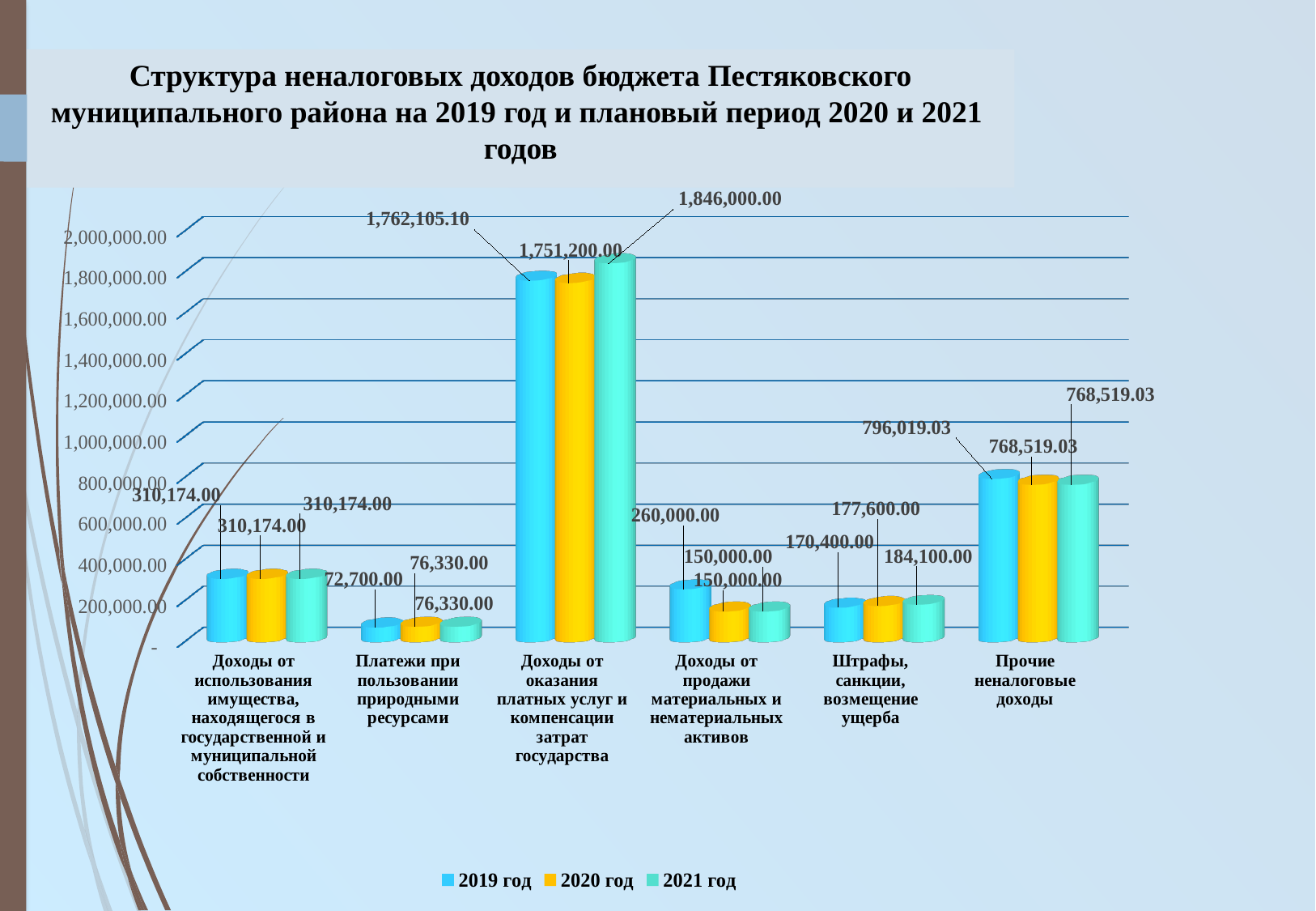
Which category has the lowest values across all three years? Платежи при пользовании природными ресурсами Is the 2019 год value for Доходы от использования имущества, находящегося в государственной и муниципальной собственности greater or less than 400,000.00? less How many series does the legend list? 3 What is the 2019 год value for Платежи при пользовании природными ресурсами? 72,700.00 What kind of chart is shown on the slide? Bar chart Which category has the highest values across all three years? Доходы от оказания платных услуг и компенсации затрат государства What is the 2020 год value for Штрафы, санкции, возмещение ущерба? 177,600.00 What is the difference between the 2019 год and 2020 год values for Доходы от продажи материальных и нематериальных активов? 110,000.00 Which is larger for Прочие неналоговые доходы: the 2019 год value or the 2021 год value? 2019 год What is the 2021 год value for Доходы от оказания платных услуг и компенсации затрат государства? 1,846,000.00 What is the 2019 год value for Прочие неналоговые доходы? 796,019.03 How many categories are shown on the x axis? 6